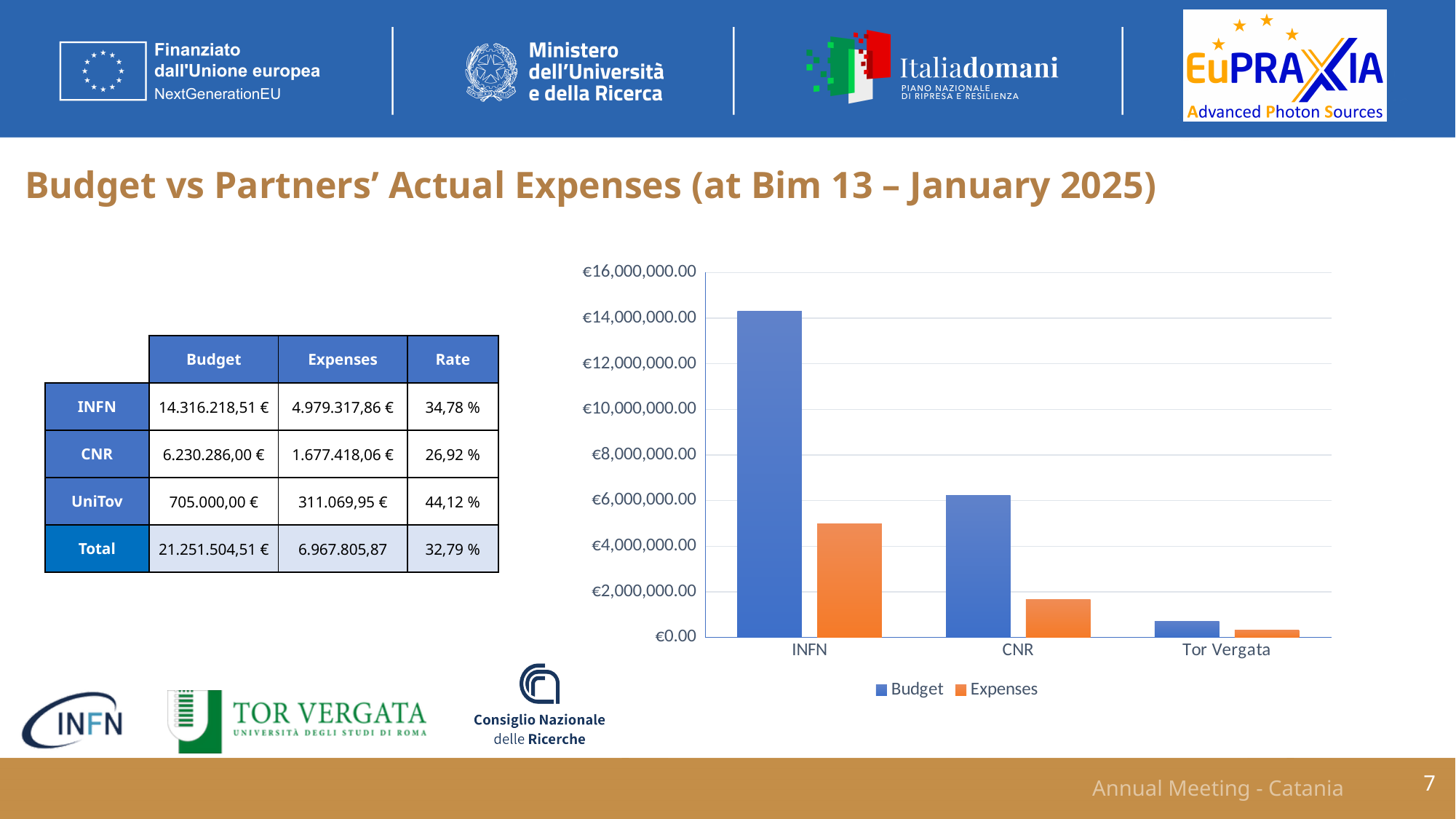
Is the Expenses value for INFN in the chart greater or less than €4,000,000.00? greater What are the two entries in the chart legend? Budget and Expenses Is the Budget value for INFN in the chart greater or less than €12,000,000.00? greater How many series does the chart legend list? 2 What kind of chart is shown on the slide? bar chart How many categories are shown on the x axis of the chart? 3 Is the Expenses value for CNR in the chart greater or less than €2,000,000.00? less Which category has the highest Budget bar in the chart? INFN Which category has the lowest Expenses bar in the chart? Tor Vergata In the chart, which is larger: the Budget bar for CNR or the Expenses bar for INFN? Budget bar for CNR According to the table on the slide, what is the Budget for INFN? 14.316.218,51 €